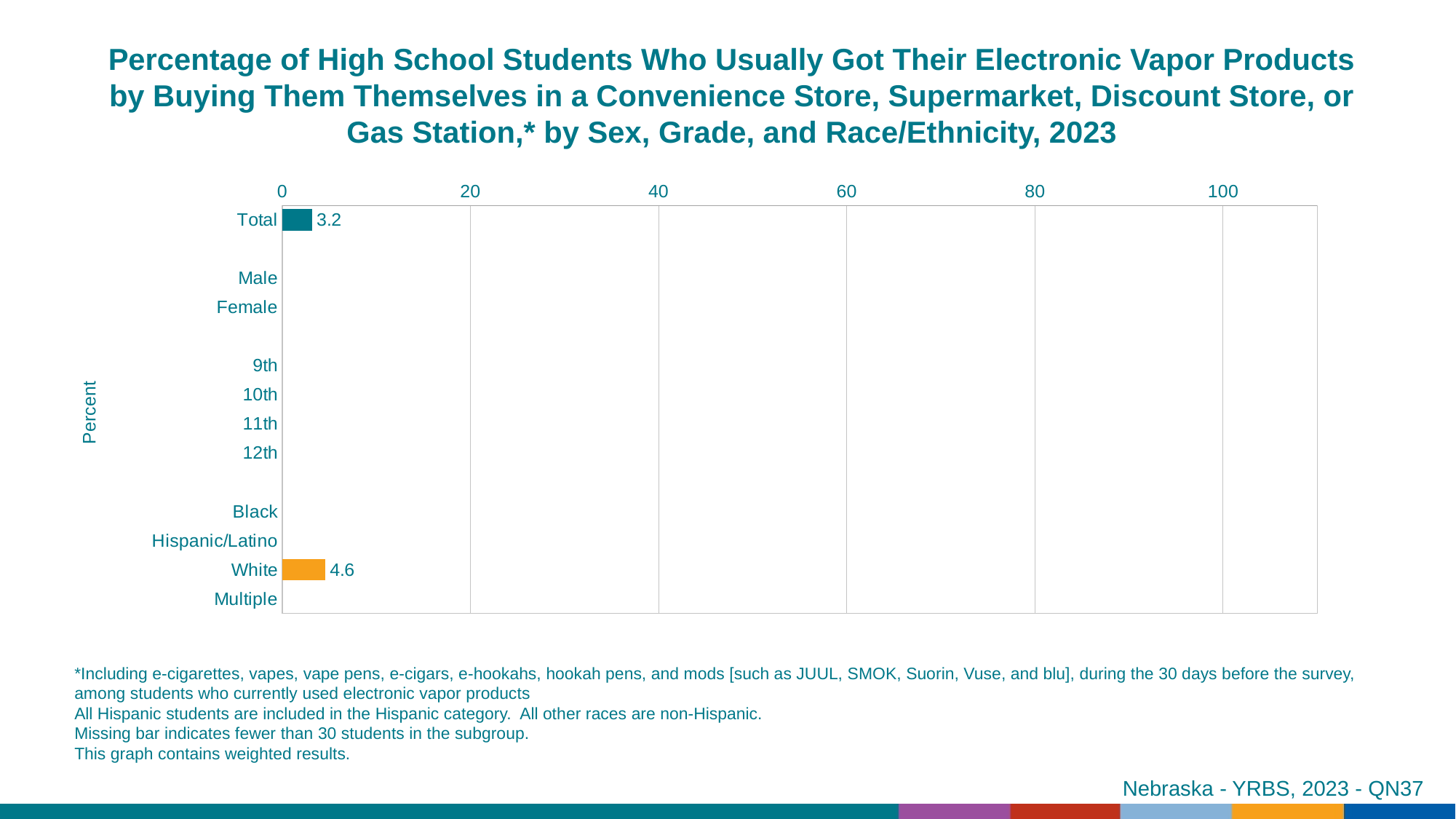
Which of the two plotted bars is larger, Total or White? White What is the value for Total? 3.2 Which category has the highest plotted value? White What does a missing bar indicate, according to the note below the chart? Fewer than 30 students in the subgroup What is the value for White? 4.6 Is the value for White greater or less than 20? less What is the difference between the value for White and the value for Total? 1.4 How many categories have a bar plotted on the chart? 2 Is the value for Total greater or less than 20? less What is the highest value shown on the horizontal axis? 100 What kind of chart is shown on the slide? bar chart How many category labels are listed on the vertical axis? 12